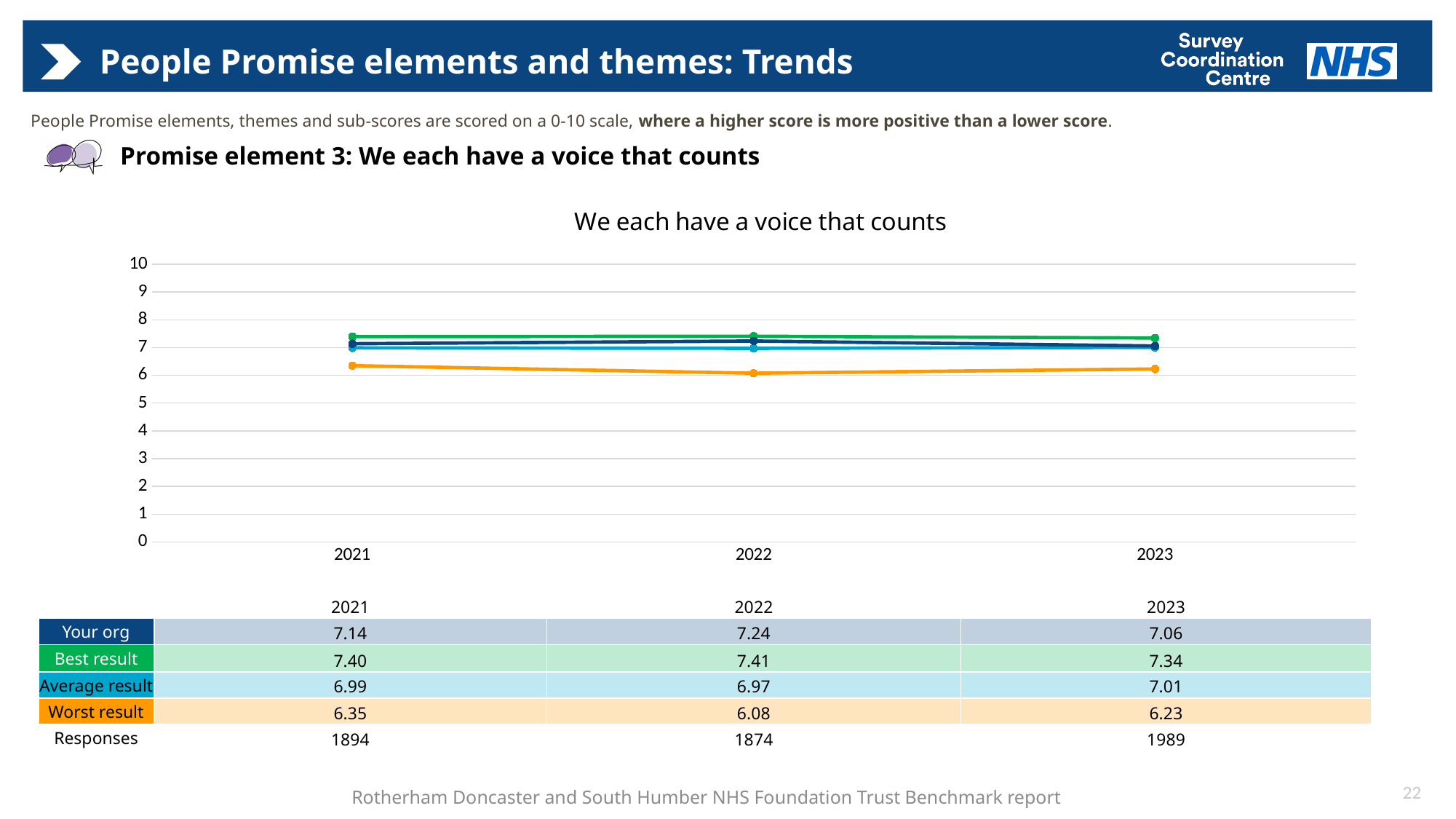
What is the title of the chart? We each have a voice that counts How many series are plotted on the chart? 4 What is the Average result value in 2022? 6.97 In which year was Your org highest? 2022 What is the Best result value in 2023? 7.34 Which is larger in 2021: Your org or Average result? Your org In which year was the Worst result lowest? 2022 What is the value for Your org in 2022? 7.24 What kind of chart is shown? Line chart What is the difference between the Best result and Your org in 2023? 0.28 What is the Worst result value in 2021? 6.35 How many years are shown on the x axis? 3